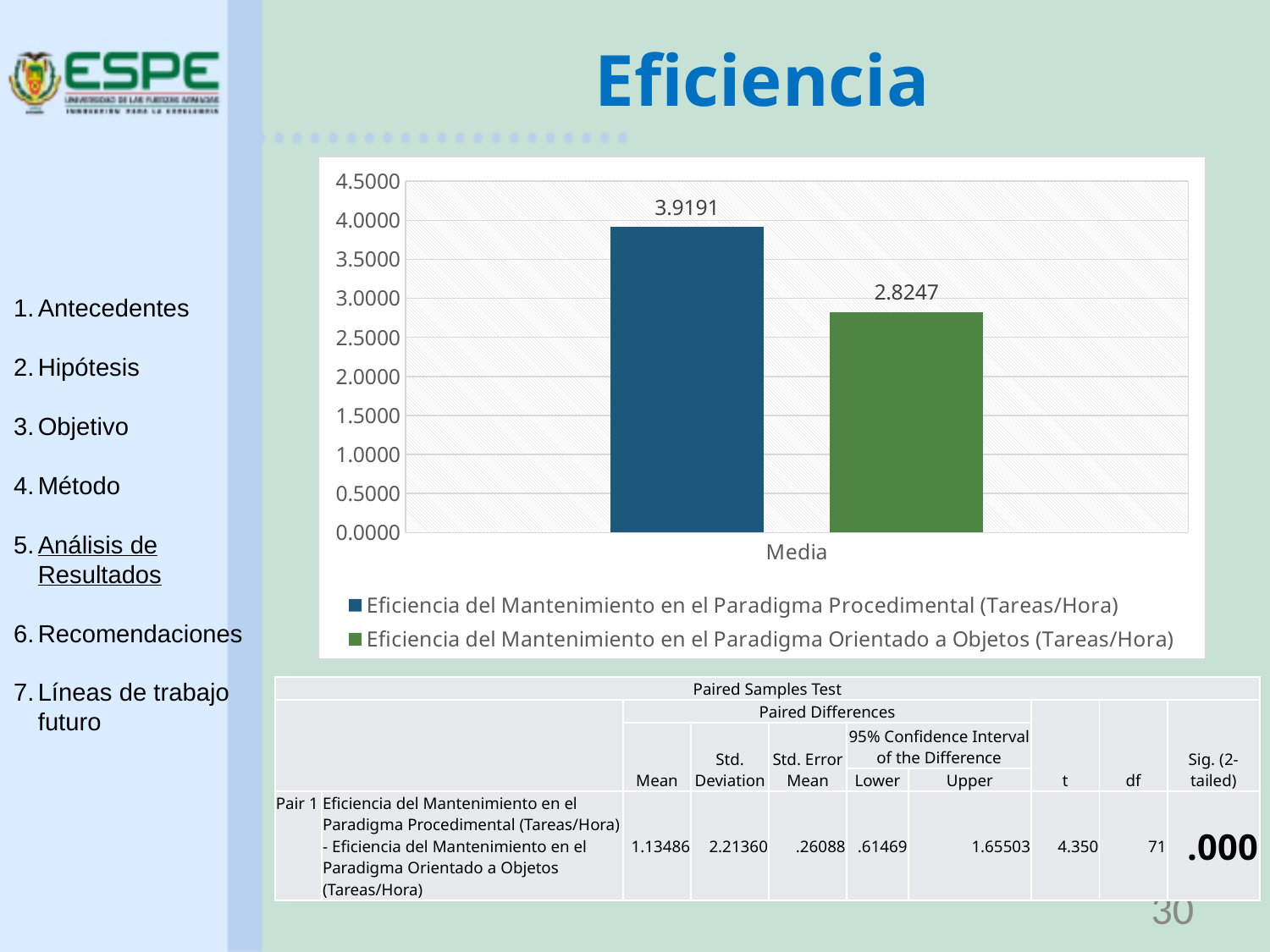
How many series does the legend list? 2 How many bars are plotted in the chart? 2 What is the category label shown on the x axis of the chart? Media What kind of chart is shown on the slide? bar chart Is the value for the Paradigma Procedimental series larger or smaller than the value for the Paradigma Orientado a Objetos series? larger What is the difference between the Paradigma Procedimental value and the Paradigma Orientado a Objetos value? 1.0944 What is the value for Eficiencia del Mantenimiento en el Paradigma Orientado a Objetos (Tareas/Hora)? 2.8247 Is the value for Eficiencia del Mantenimiento en el Paradigma Orientado a Objetos greater or less than 3.0000? less Is the value for Eficiencia del Mantenimiento en el Paradigma Procedimental greater or less than 3.5000? greater Which series has the lower value in the chart? Eficiencia del Mantenimiento en el Paradigma Orientado a Objetos (Tareas/Hora) What is the value for Eficiencia del Mantenimiento en el Paradigma Procedimental (Tareas/Hora)? 3.9191 Which series has the higher value in the chart? Eficiencia del Mantenimiento en el Paradigma Procedimental (Tareas/Hora)